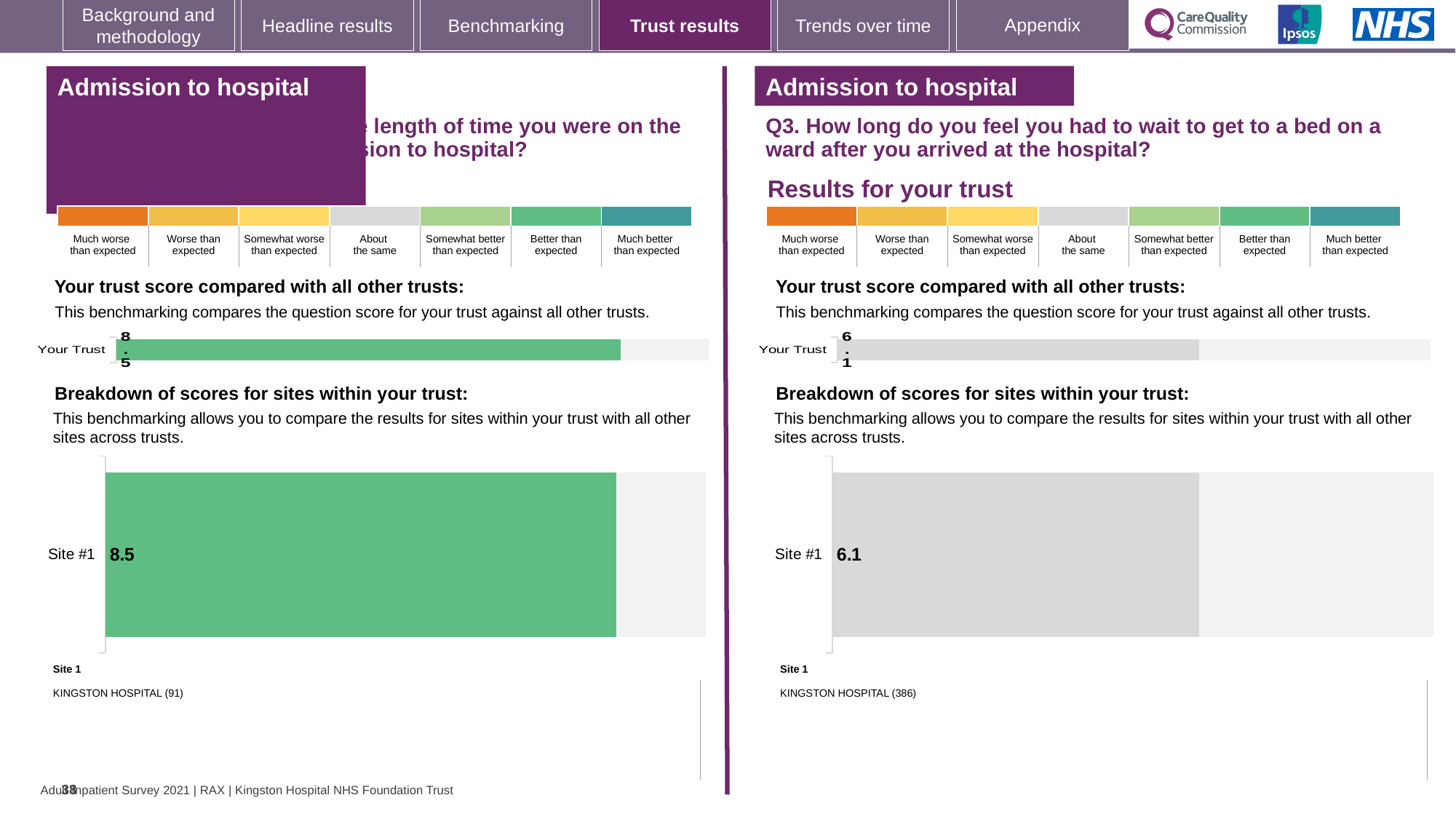
On the left half of the slide, what is the score shown for Site #1 in the breakdown of scores for sites within your trust? 8.5 On the right half of the slide (Q3), which benchmark category does the grey colour of the Site #1 bar correspond to in the colour key? About the same On the right half of the slide (Q3), what value is shown for 'Your Trust' in the trust score comparison chart? 6.1 How many sites are shown in the breakdown of scores chart on the left half of the slide? 1 On the left half of the slide, which benchmark category does the green colour of the Site #1 bar correspond to in the colour key? Better than expected How many sites are shown in the breakdown of scores chart on the right half of the slide (Q3)? 1 What is the difference between the Site #1 score on the left half of the slide and the Site #1 score on the right half (Q3)? 2.4 On the left half of the slide, what value is shown for 'Your Trust' in the trust score comparison chart? 8.5 Which Site #1 score is larger: the one on the left half of the slide or the one on the right half (Q3)? The left half (8.5) On the right half of the slide (Q3), which site name is listed as Site 1 below the chart? KINGSTON HOSPITAL (386) On the right half of the slide (Q3), what is the score shown for Site #1 in the breakdown of scores for sites within your trust? 6.1 What type of chart is used to show the Site #1 score on the right half of the slide (Q3)? Bar chart